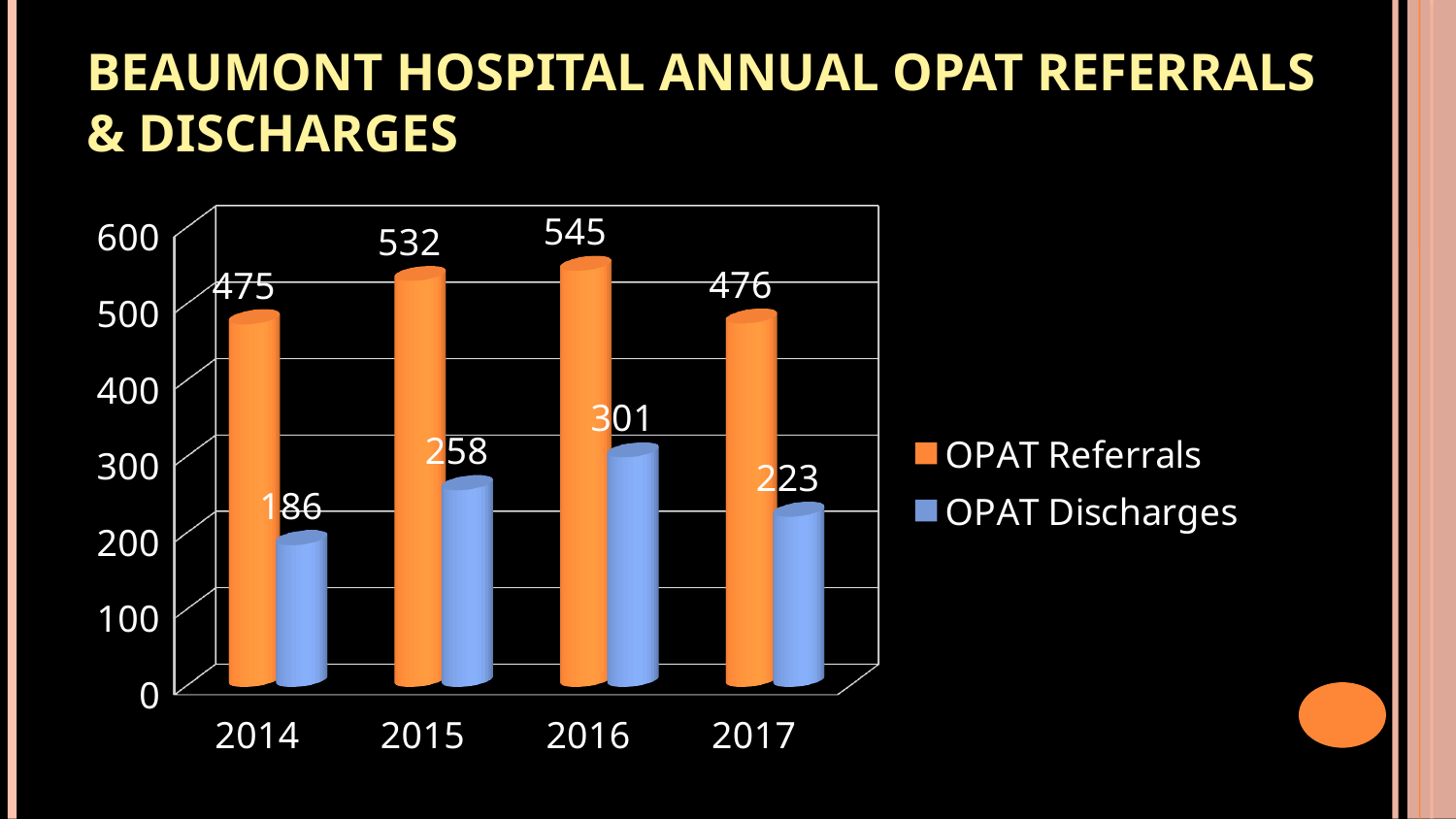
How many series does the legend list? 2 What is the value of OPAT Referrals for 2016? 545 What is the difference between OPAT Referrals and OPAT Discharges in 2015? 274 What is the value of OPAT Discharges for 2014? 186 Which year has the highest OPAT Referrals? 2016 Do OPAT Discharges rise or fall from 2014 to 2016? rise Is the value of OPAT Discharges for 2016 greater or less than 300? greater Which is larger, OPAT Referrals in 2014 or OPAT Referrals in 2017? OPAT Referrals in 2017 What kind of chart is shown on the slide? bar chart How many years are shown on the x axis? 4 What is the value of OPAT Discharges for 2017? 223 Which year has the lowest OPAT Discharges? 2014